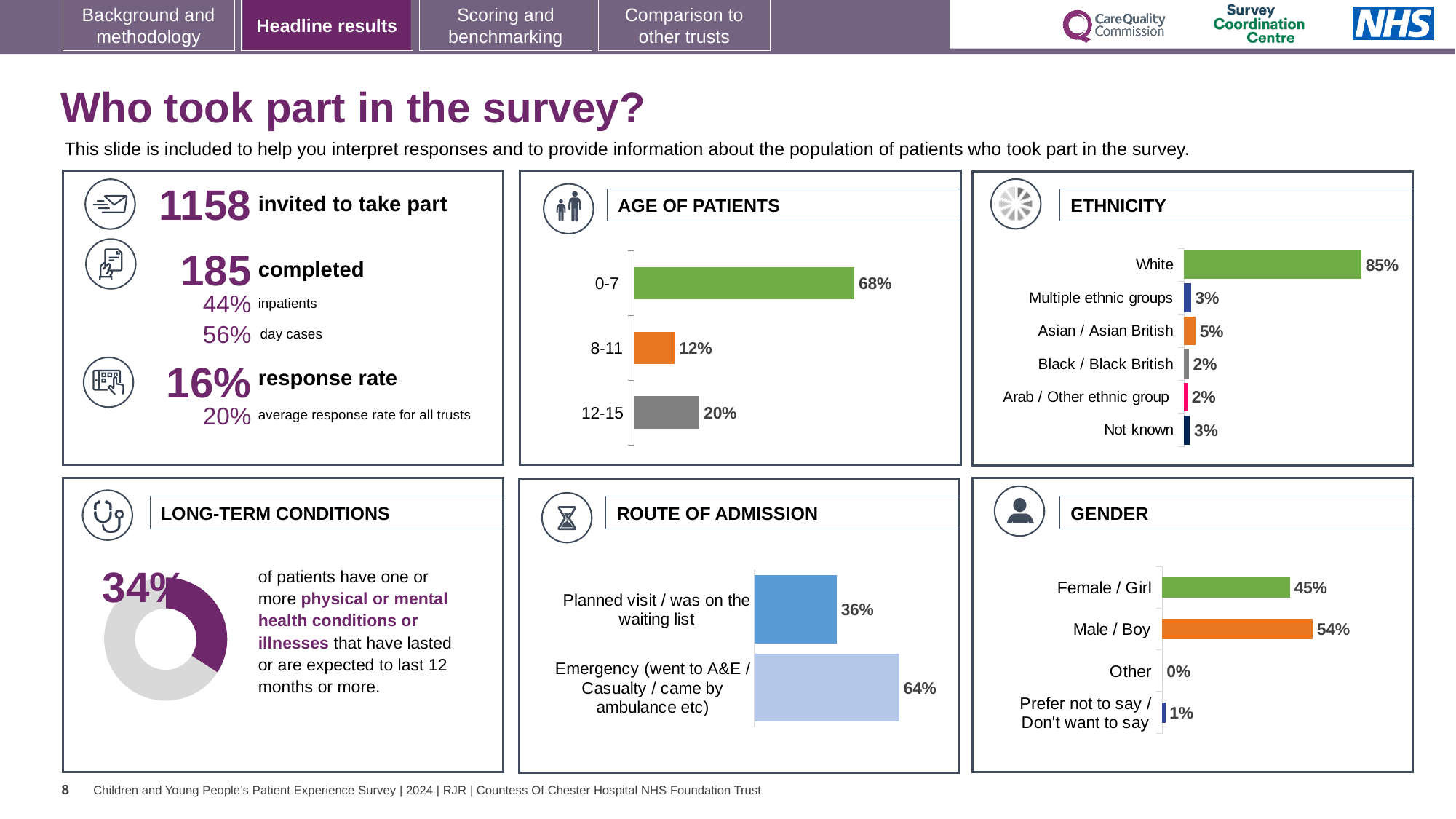
In the ROUTE OF ADMISSION chart, what percentage of patients came via Emergency (went to A&E / Casualty / came by ambulance etc)? 64% In the ETHNICITY chart, how many ethnicity categories are shown? 6 In the ETHNICITY chart, what percentage of patients were White? 85% In the AGE OF PATIENTS chart, which age group has the lowest percentage? 8-11 In the AGE OF PATIENTS chart, what percentage of patients were aged 0-7? 68% What kind of chart is used in the LONG-TERM CONDITIONS panel? Donut (pie) chart In the ETHNICITY chart, which is larger: Asian / Asian British or Black / Black British? Asian / Asian British In the GENDER chart, what percentage of patients were Male / Boy? 54% In the AGE OF PATIENTS chart, what is the difference between the 12-15 and 8-11 percentages? 8% In the GENDER chart, which category has the lowest percentage? Other In the ETHNICITY chart, which category has the highest percentage? White In the ROUTE OF ADMISSION chart, what is the difference between the Emergency and Planned visit percentages? 28%